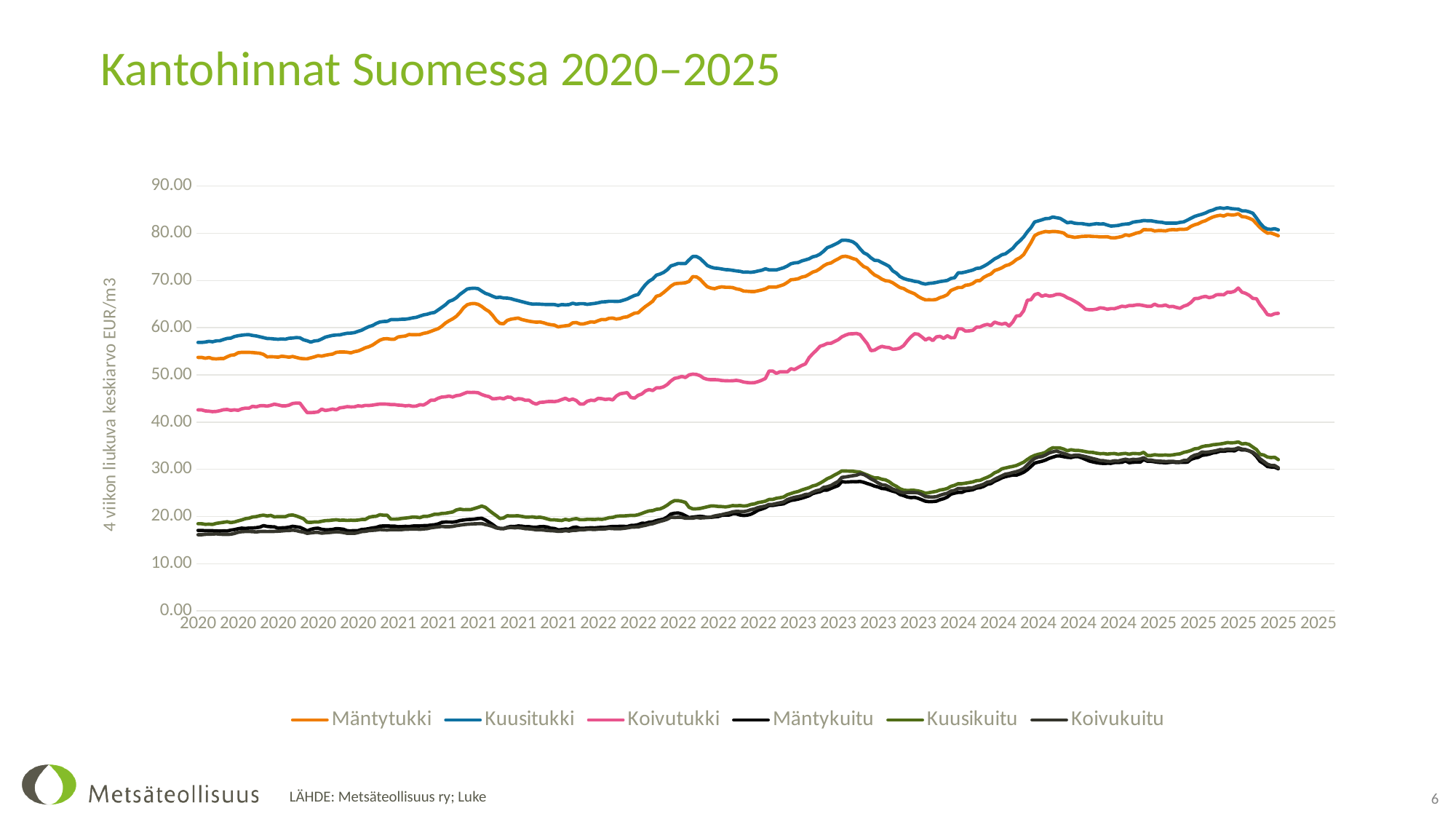
What is the label on the vertical axis? 4 viikon liukuva keskiarvo EUR/m3 What is the title of the chart? Kantohinnat Suomessa 2020–2025 Which is larger throughout the period, Kuusitukki or Mäntytukki? Kuusitukki Is the peak value of Kuusitukki in 2025 greater or less than 80? greater How many series does the legend list? 6 Is the value for Mäntykuitu at the start of 2020 greater or less than 20? less What kind of chart is shown on the slide? line chart Is the value for Kuusitukki at the start of 2020 greater or less than 50? greater Which series has the highest values across the whole period? Kuusitukki Among Mäntykuitu, Kuusikuitu and Koivukuitu, which series runs highest? Kuusikuitu Does the Koivutukki series rise or fall overall from 2020 to 2025? rise Which is larger at the end of the period, Mäntytukki or Koivutukki? Mäntytukki